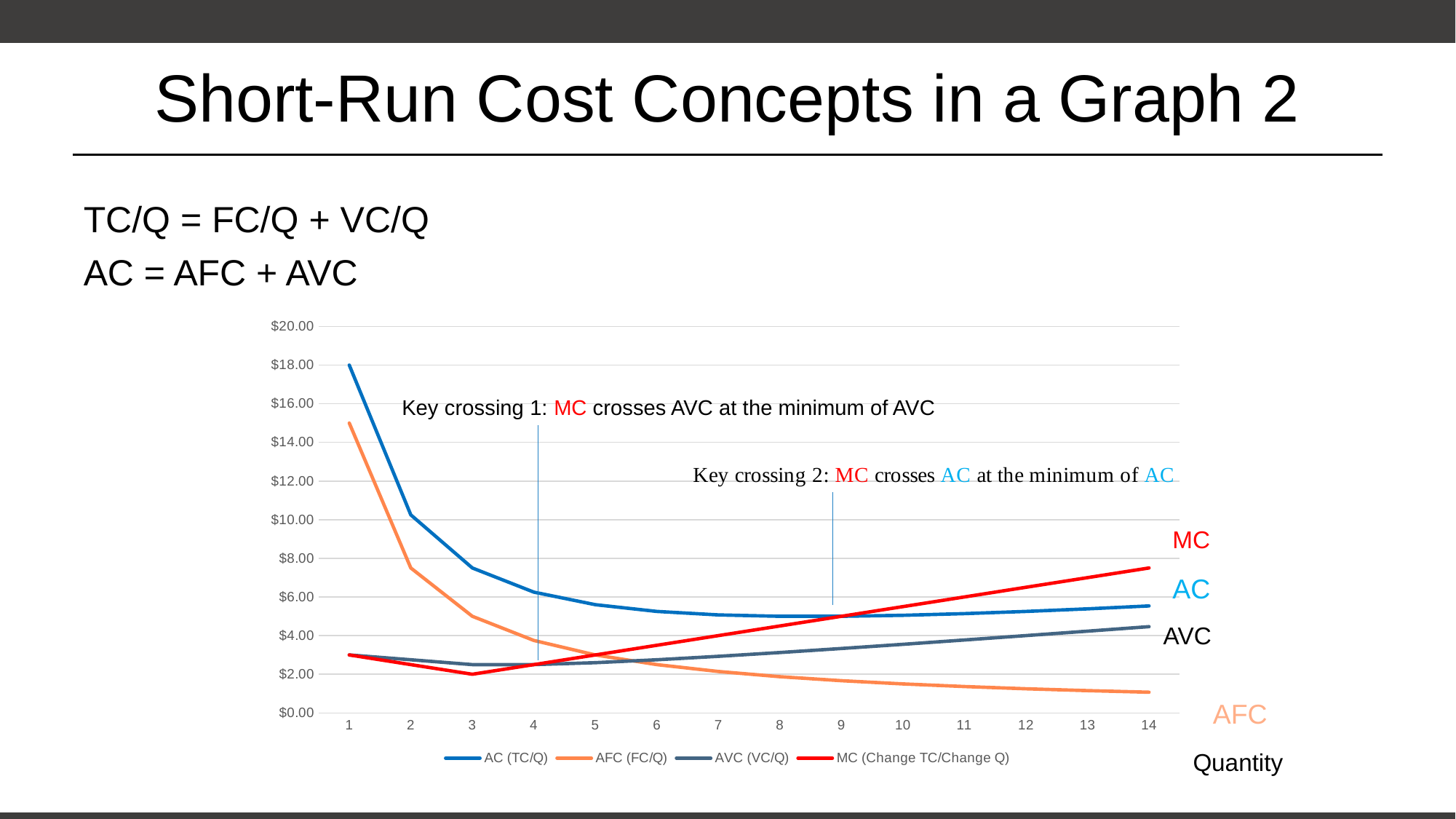
At quantity 14, which is larger, MC or AC? MC Which series has the highest value at quantity 1? AC (TC/Q) Is the value of AFC at quantity 14 greater or less than $2.00? less Is the value of AC at quantity 2 greater or less than $10.00? greater Is the value of MC at quantity 14 greater or less than $8.00? less What is the value of MC at quantity 3? $2.00 Does the AFC (FC/Q) series rise or fall as quantity increases from 1 to 14? fall What kind of chart is shown on the slide? line chart What is the value of AC (TC/Q) at quantity 1? $18.00 How many quantity values are plotted along the x axis? 14 How many series does the chart legend list? 4 Which series has the lowest value at quantity 14? AFC (FC/Q)